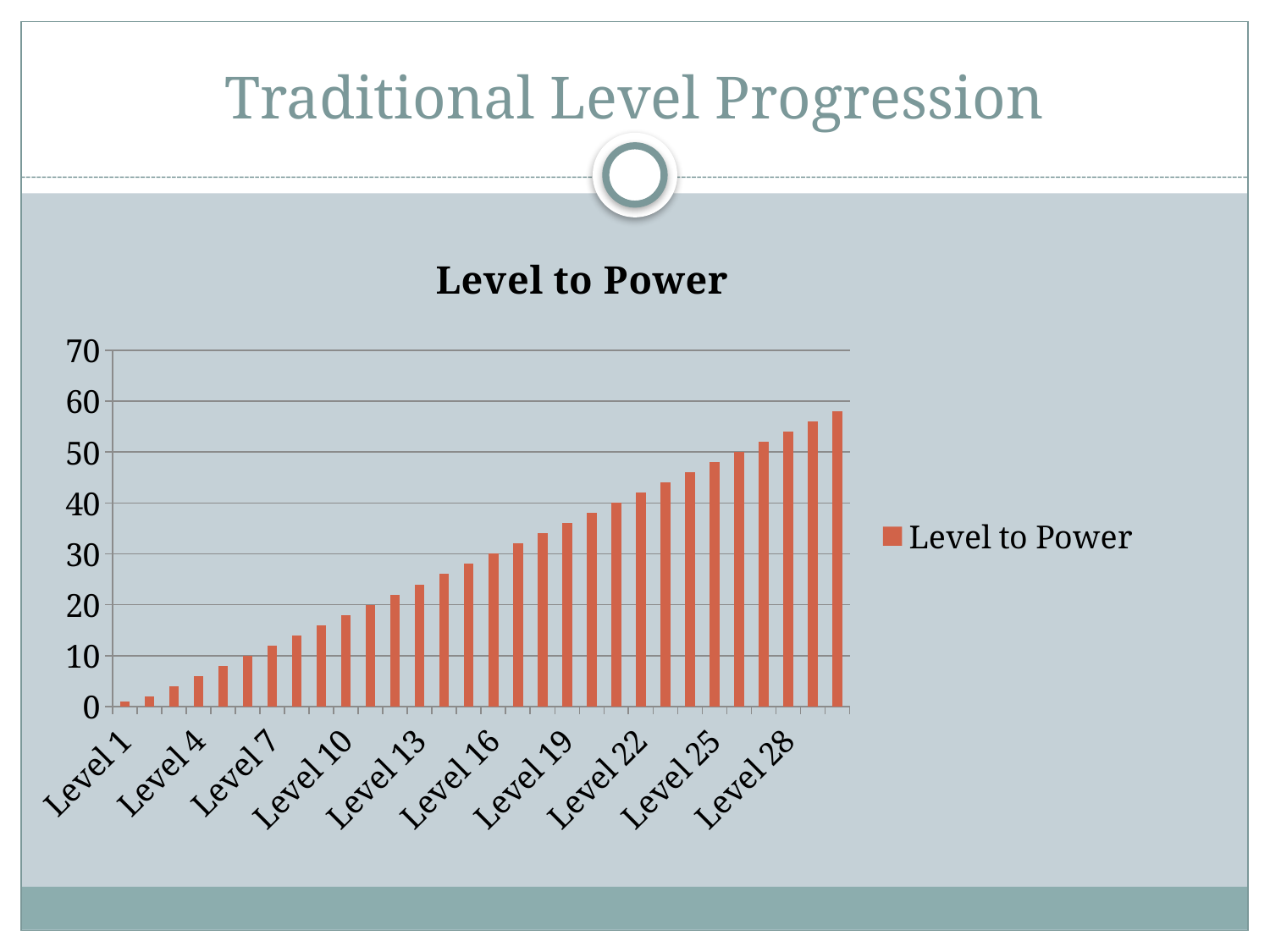
How many bars are plotted in the chart? 30 Is the value for Level 28 greater or less than 50? greater Is the value for Level 7 greater or less than 10? greater Do the values rise or fall as the level increases along the x axis? rise What is the title of the chart? Level to Power Which labeled level has the lowest value? Level 1 What type of chart is shown on the slide? bar chart How many series does the legend list? 1 What is the value for Level 16? 30 Which is larger, the value for Level 22 or the value for Level 10? Level 22 Is the value for Level 13 greater or less than 20? greater